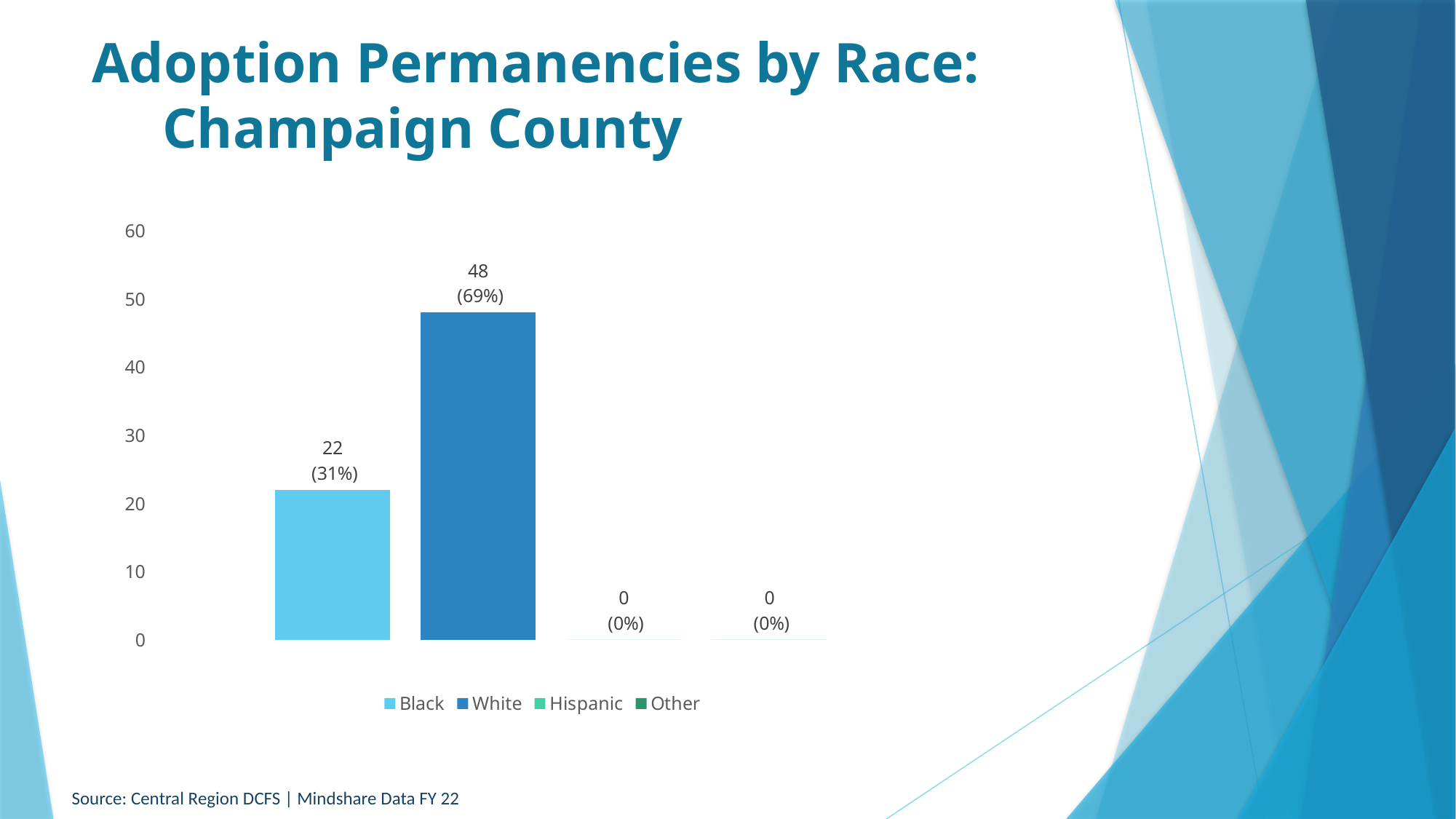
What percentage is shown for Black? 31% Which category has the highest value? White How many categories does the legend list? 4 What is the title of the slide? Adoption Permanencies by Race: Champaign County What is the value for White? 48 What is the value for Black? 22 Is the value for White greater or less than 40? greater What is the total of the values for Black and White? 70 Which is larger, the value for Black or the value for White? White What is the value for Hispanic? 0 What kind of chart is shown on the slide? Bar chart What is the difference between the values for White and Black? 26